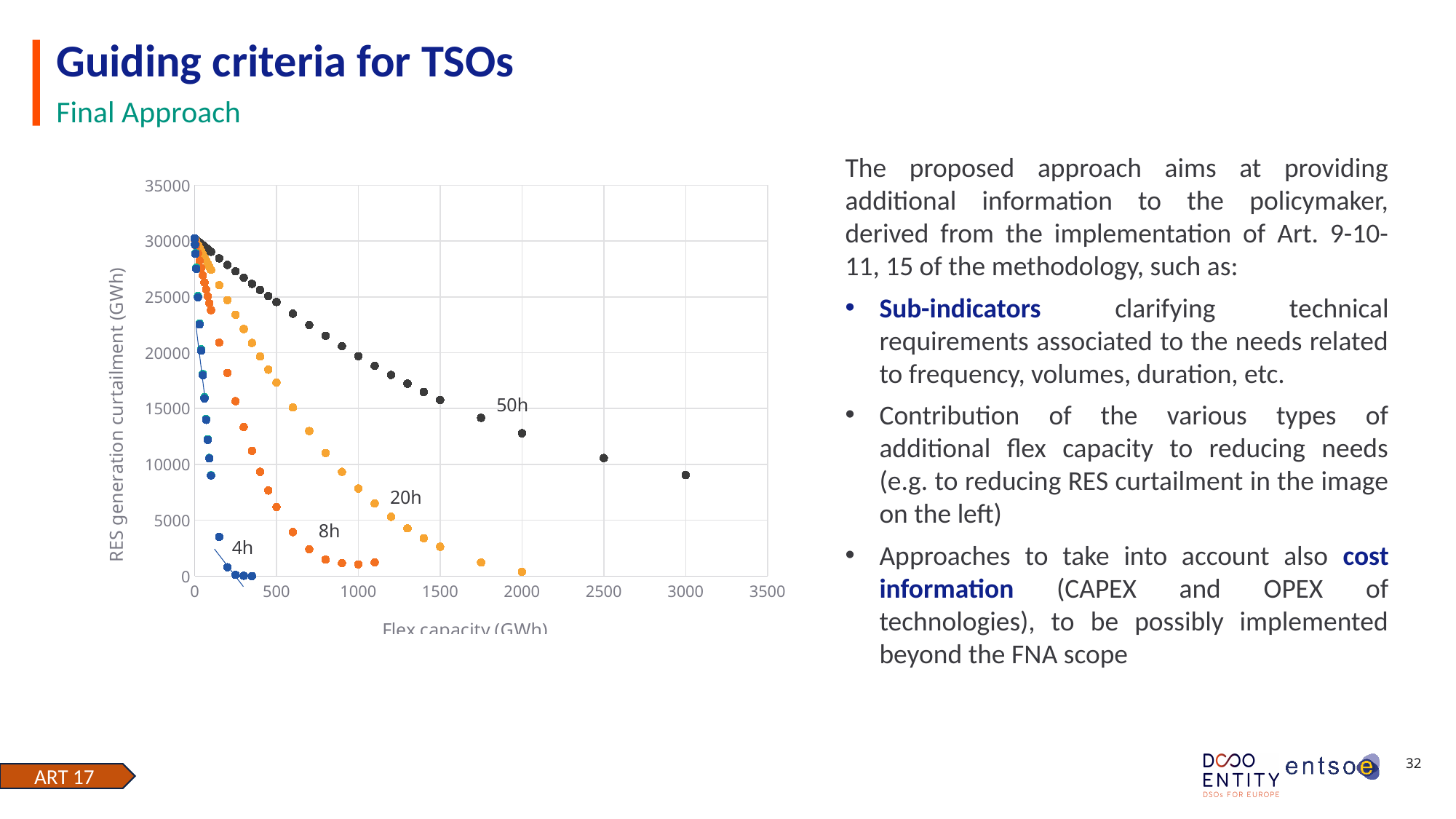
Is the RES generation curtailment of the 8h series at a flex capacity of 1000 GWh greater or less than 5000? less What is the title of the x axis of the chart? Flex capacity (GWh) At a flex capacity of 1000 GWh, which series has the higher RES generation curtailment, 50h or 20h? 50h What is the maximum value shown on the y axis of the chart? 35000 What is the title of the y axis of the chart? RES generation curtailment (GWh) Is the RES generation curtailment of the 50h series at a flex capacity of 2000 GWh greater or less than 10000? greater What kind of chart is shown on the slide? scatter chart Which labelled series reaches zero curtailment at the smallest flex capacity? 4h Which labelled series extends furthest along the x axis (to the highest flex capacity)? 50h How many series (duration curves) are labelled on the chart? 4 As flex capacity increases along the x axis, do the RES generation curtailment values rise or fall? fall Is the RES generation curtailment of the 20h series at a flex capacity of 2000 GWh greater or less than 5000? less